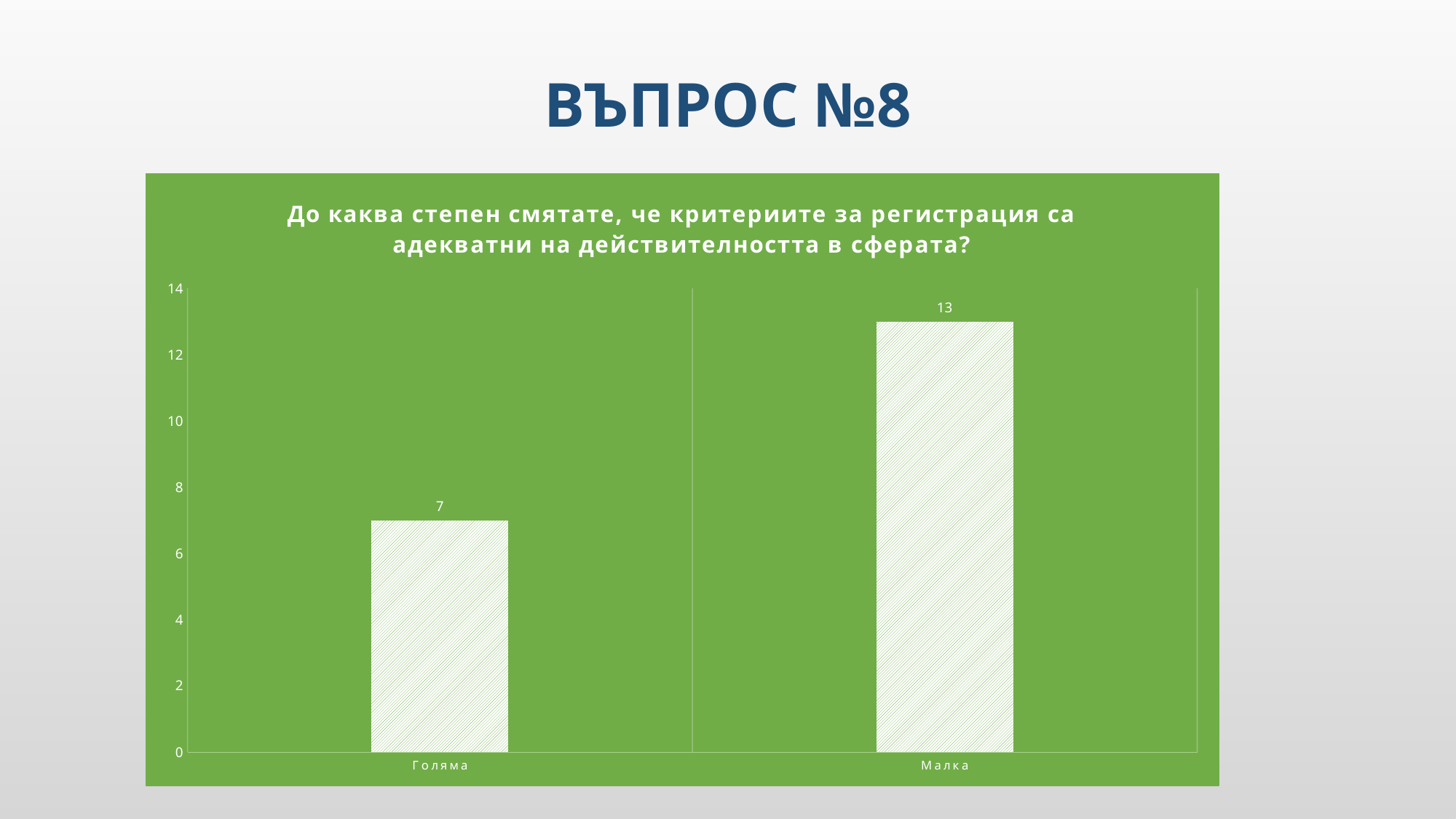
What is the difference between the values for Малка and Голяма? 6 Which category has the highest value? Малка Which category has the lowest value? Голяма What is the value for Малка? 13 Which is larger, the value for Голяма or the value for Малка? Малка What is the maximum value shown on the y axis? 14 What kind of chart is shown on the slide? bar chart What is the title of the chart? До каква степен смятате, че критериите за регистрация са адекватни на действителността в сферата? Is the value for Голяма greater or less than 8? less What is the value for Голяма? 7 How many categories are shown on the x axis? 2 Is the value for Малка greater or less than 10? greater